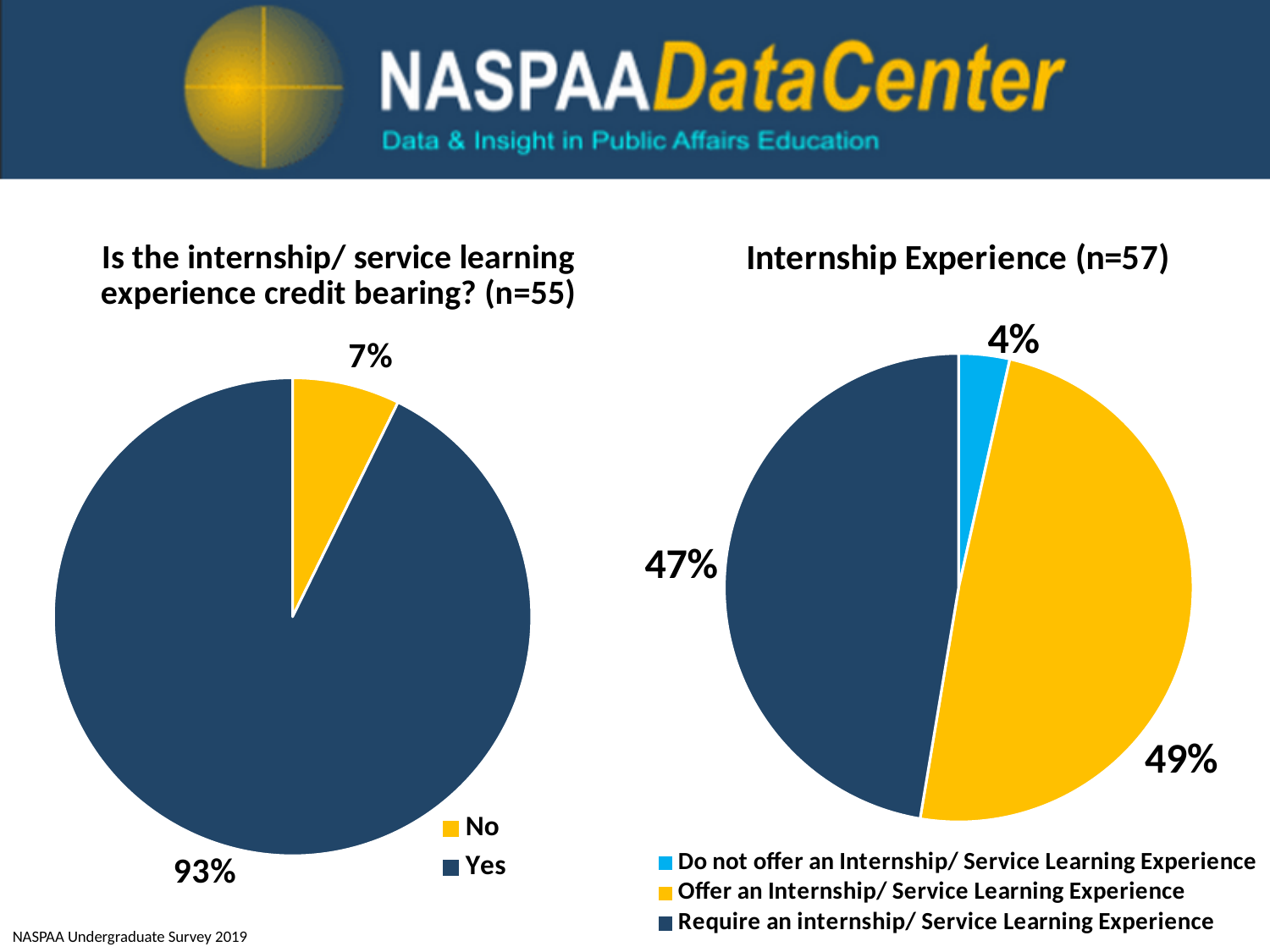
In the 'Internship Experience (n=57)' chart, what share of programs offer an internship/ service learning experience? 49% In the 'Is the internship/ service learning experience credit bearing? (n=55)' chart, what percentage answered No? 7% In the 'Internship Experience (n=57)' chart, which category has the smallest slice? Do not offer an Internship/ Service Learning Experience In the 'Internship Experience (n=57)' chart, what share of programs require an internship/ service learning experience? 47% What type of chart is the 'Is the internship/ service learning experience credit bearing? (n=55)' chart? Pie chart In the 'Internship Experience (n=57)' chart, what is the difference between the share that offer and the share that require an internship/ service learning experience? 2% In the 'Is the internship/ service learning experience credit bearing? (n=55)' chart, what colour represents the No slice? Yellow In the 'Internship Experience (n=57)' chart, which category has the largest slice? Offer an Internship/ Service Learning Experience In the 'Is the internship/ service learning experience credit bearing? (n=55)' chart, what is the difference between the Yes and No percentages? 86% In the 'Is the internship/ service learning experience credit bearing? (n=55)' chart, what percentage answered Yes? 93% In the 'Internship Experience (n=57)' chart, what share of programs do not offer an internship/ service learning experience? 4% How many categories does the legend of the 'Internship Experience (n=57)' chart list? 3